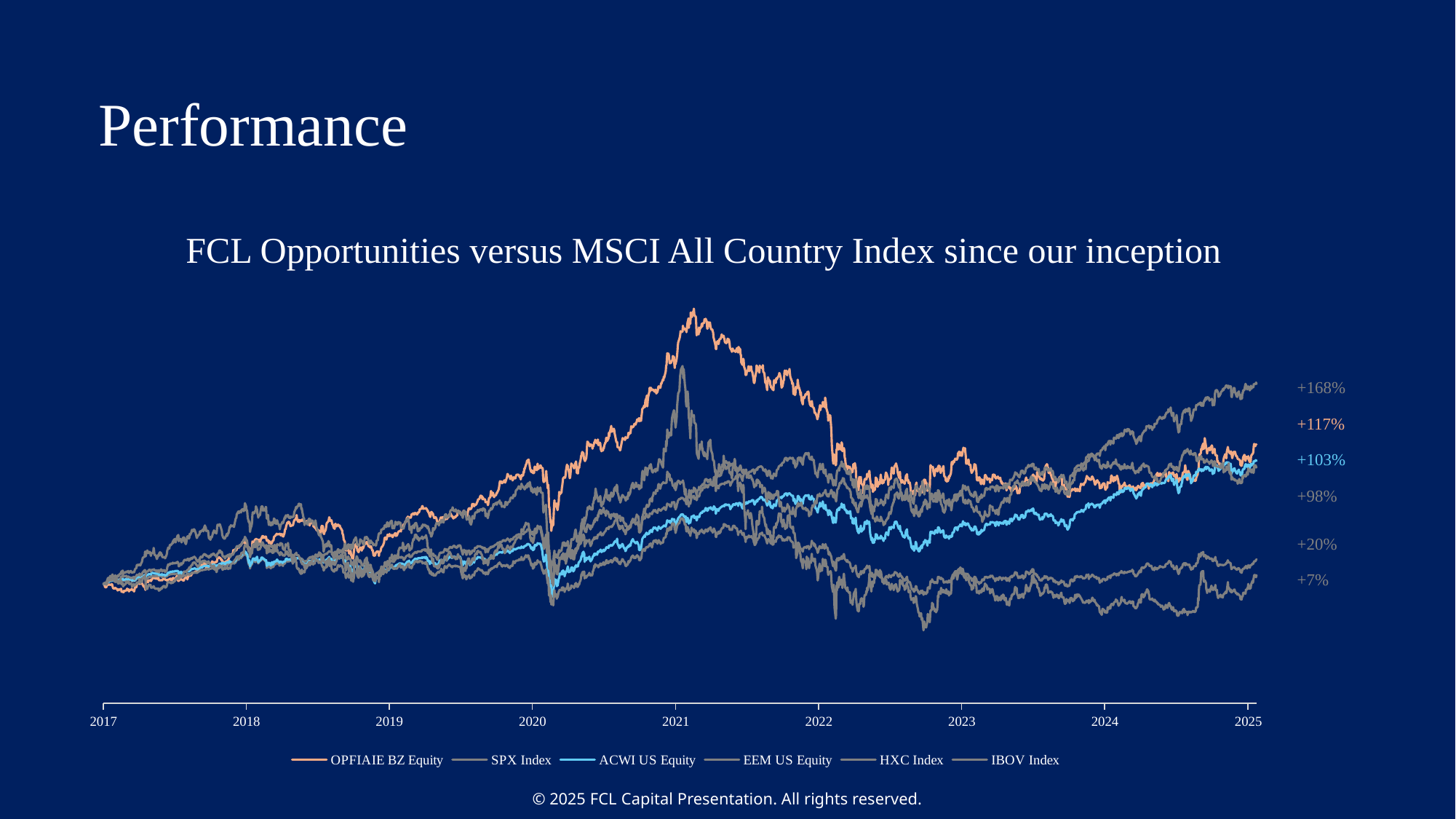
How many series does the legend list? 6 What is the difference between the end-of-period return labels for OPFIAIE BZ Equity (+117%) and ACWI US Equity (+103%)? 14 percentage points What is the end-of-period return label shown for OPFIAIE BZ Equity? +117% What colour is the OPFIAIE BZ Equity line? Orange What kind of chart is shown on the slide? Line chart What is the highest end-of-period return label shown on the right of the chart? +168% Which has the higher end-of-period return, OPFIAIE BZ Equity or ACWI US Equity? OPFIAIE BZ Equity Does the ACWI US Equity line rise or fall overall from 2017 to 2025? Rise What is the end-of-period return label shown for ACWI US Equity? +103% What is the title of the chart? FCL Opportunities versus MSCI All Country Index since our inception How many year labels are shown on the x axis? 9 What is the lowest end-of-period return label shown on the right of the chart? +7%